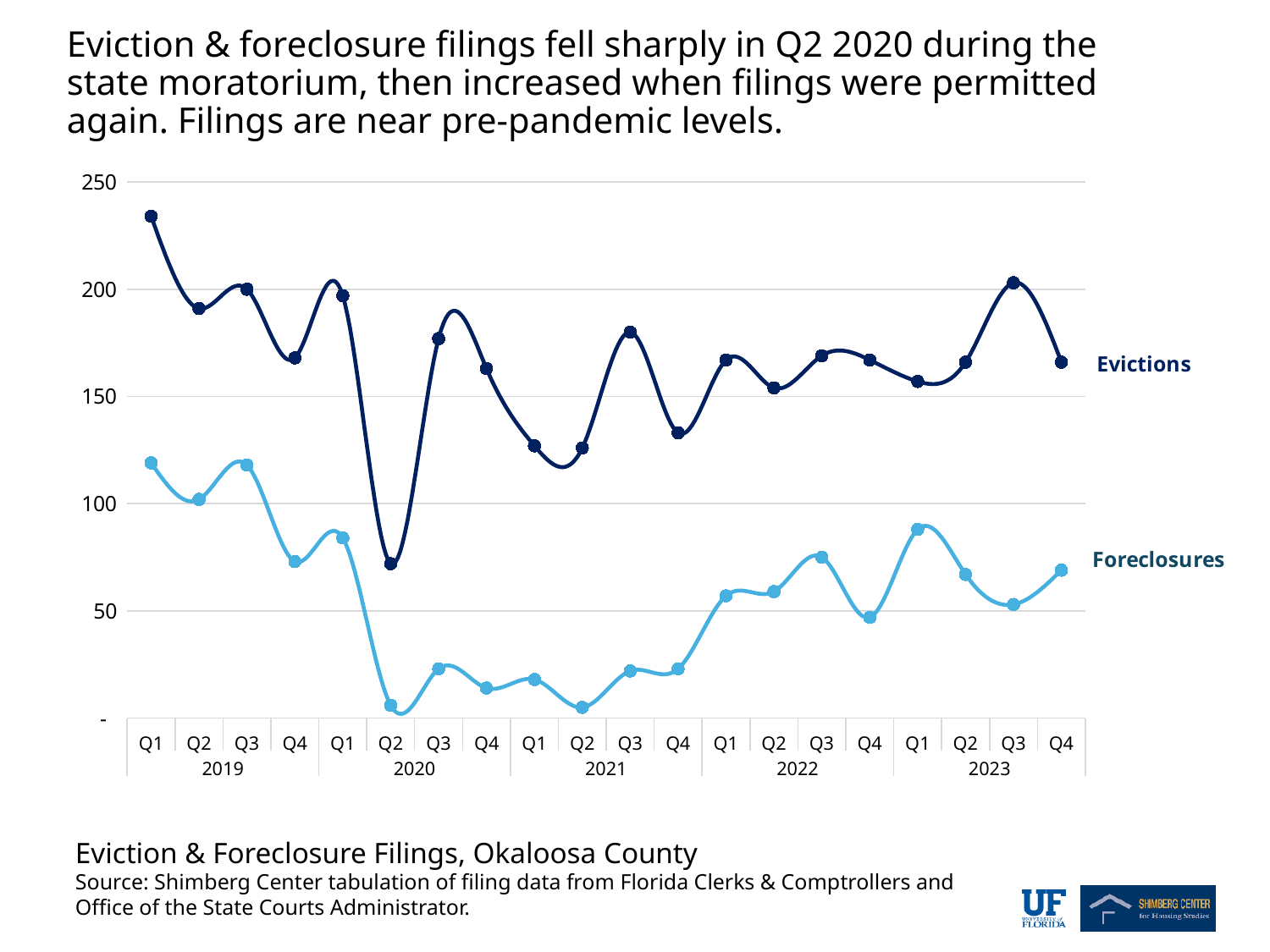
In which quarter is the Evictions line at its lowest? Q2 2020 Is the value for Foreclosures in Q2 2020 greater or less than 50? less Is the value for Evictions in Q2 2020 greater or less than 100? less In which quarter is the Evictions line at its highest? Q1 2019 What kind of chart is shown on the slide? Line chart What are the names of the two series plotted on the chart? Evictions and Foreclosures Is the value for Foreclosures in Q1 2023 greater or less than 50? greater In Q4 2023, which series has the larger value, Evictions or Foreclosures? Evictions How many quarterly data points does each line have? 20 Do Foreclosure filings rise or fall from Q1 2019 to Q2 2020? Fall How many series are plotted on the chart? 2